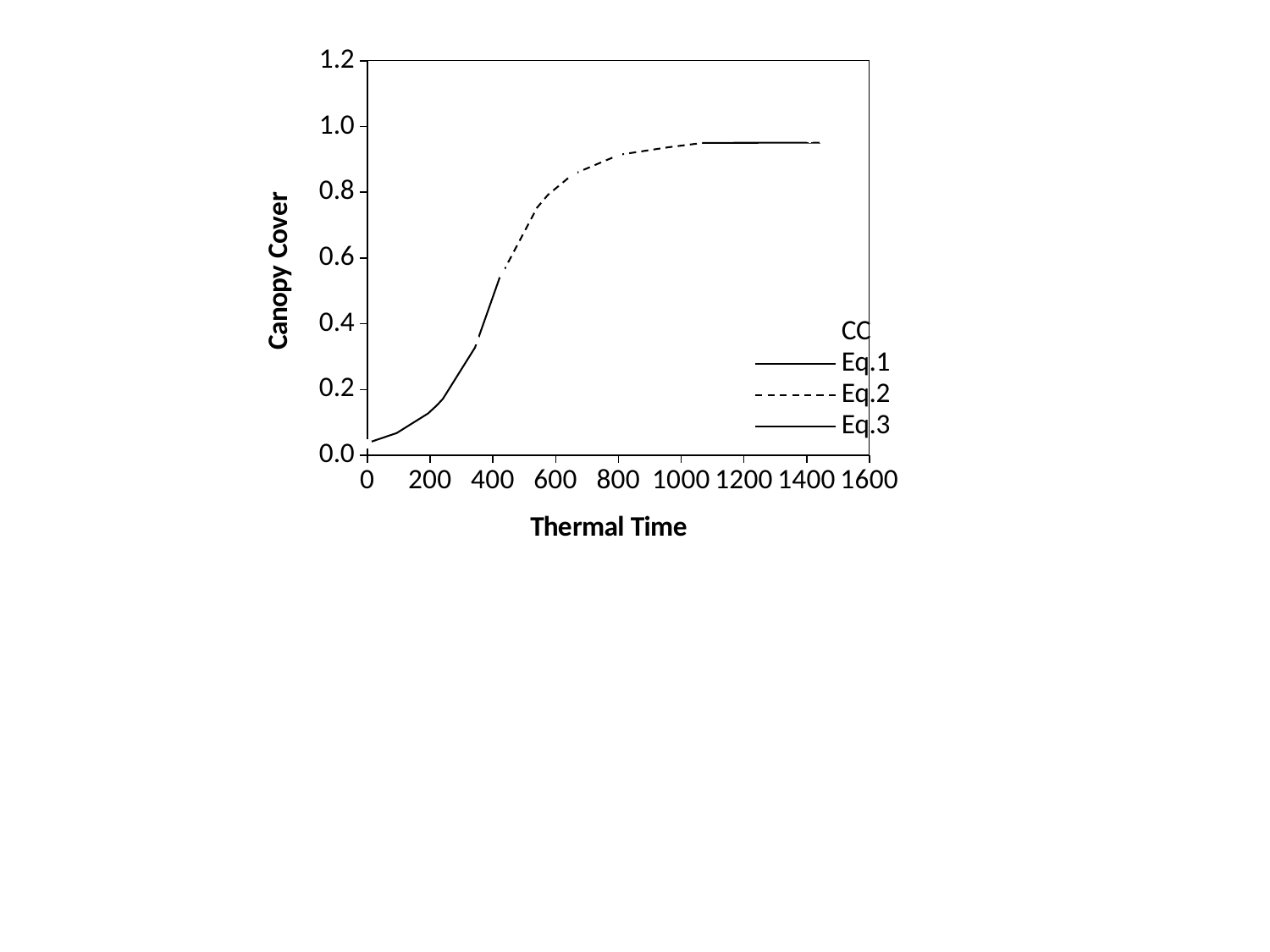
Is the Canopy Cover value at a Thermal Time of 600 greater or less than 0.6? greater Which series is drawn with a dashed line? Eq.2 Is the Canopy Cover value at a Thermal Time of 1200 greater or less than 1.0? less Is the Canopy Cover value at a Thermal Time of 200 greater or less than 0.2? less How many series does the legend list? 4 Does the Canopy Cover rise or fall as Thermal Time increases? rise What is the label of the y axis? Canopy Cover What kind of chart is shown on the slide? line chart Is the Canopy Cover at a Thermal Time of 1000 larger or smaller than at a Thermal Time of 200? larger What is the label of the x axis? Thermal Time